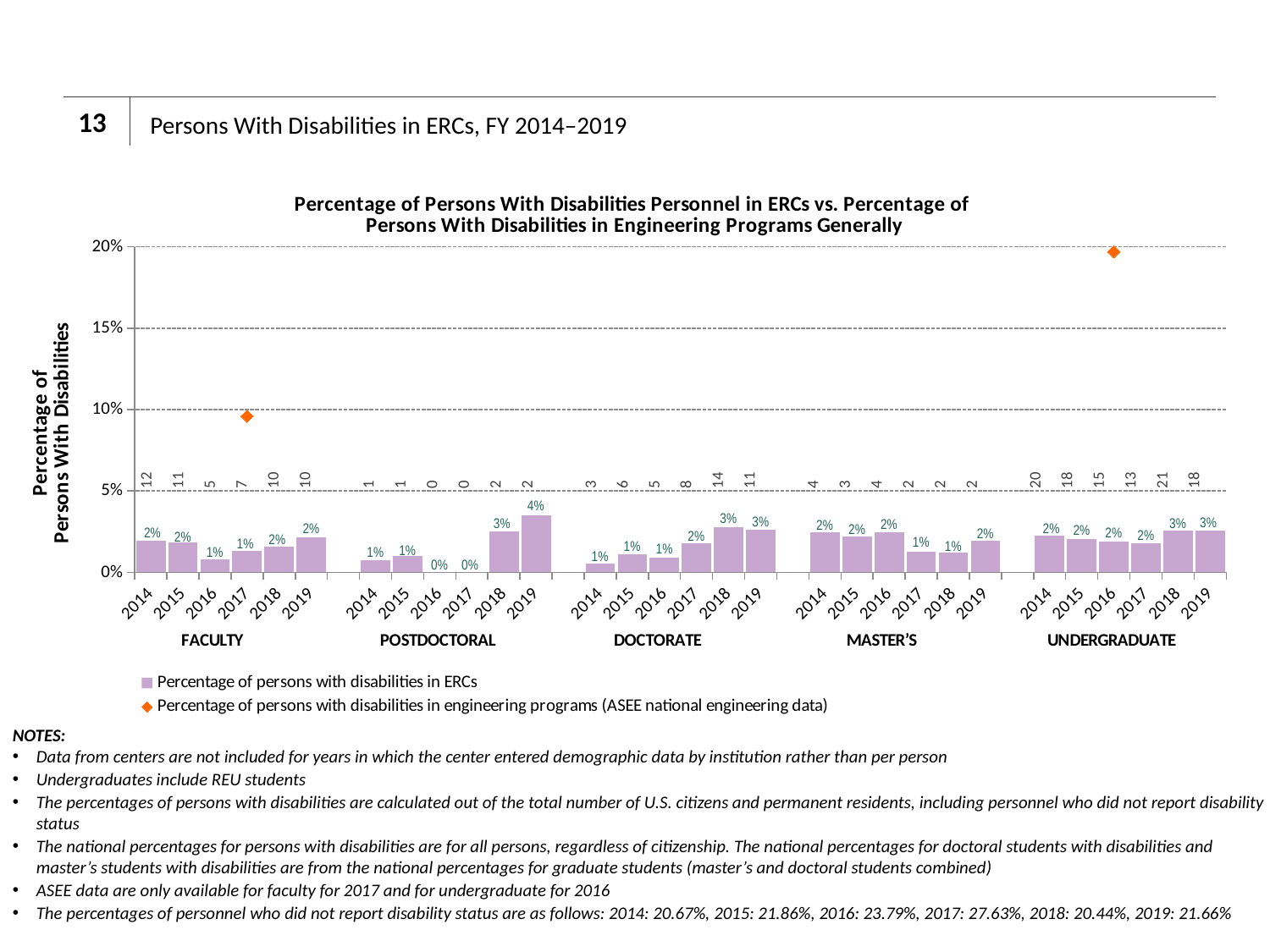
What number is printed above the Undergraduate 2018 bar? 21 How many series does the legend list? 2 Which is larger, the Doctorate percentage in 2018 or in 2014? 2018 Is the ASEE national engineering data value for Undergraduate in 2016 greater or less than 15%? greater Which group and year has the highest percentage of persons with disabilities in ERCs? Postdoctoral 2019 What kind of chart is shown on the slide? bar chart What is the percentage of persons with disabilities in ERCs for Faculty in 2016? 1% How many personnel groups (categories) are shown along the x axis? 5 What is the difference between the Postdoctoral percentage in 2019 and in 2014? 3% What is the percentage of persons with disabilities in ERCs for Postdoctoral in 2019? 4% Is the ASEE national engineering data value for Faculty in 2017 greater or less than 10%? less What is the percentage of persons with disabilities in ERCs for Doctorate in 2018? 3%